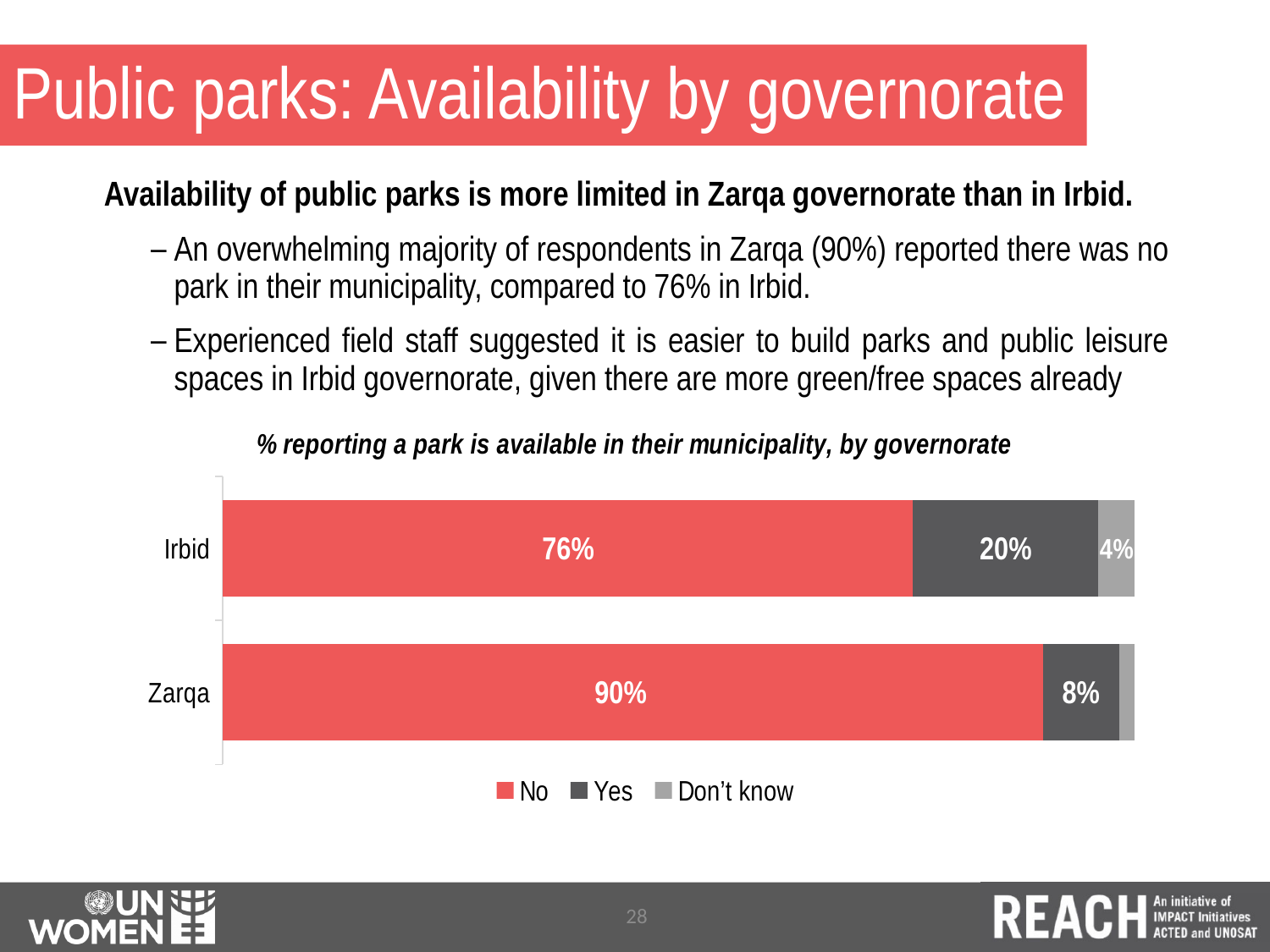
Which governorate has the larger "Yes" value, Irbid or Zarqa? Irbid How many governorates are shown in the chart? 2 What percentage of respondents in Irbid reported there was no park in their municipality? 76% What is the total of the labelled segments in the Irbid bar? 100% What is the "Don't know" value for Irbid? 4% What type of chart is shown on the slide? Stacked bar chart What is the difference between the "Yes" values for Irbid and Zarqa? 12% What is the difference between the "No" values for Zarqa and Irbid? 14% What is the "No" value for Zarqa? 90% How many series does the legend list? 3 What percentage of respondents in Zarqa answered "Yes" that a park is available? 8% Which governorate has the higher share of respondents answering "No"? Zarqa